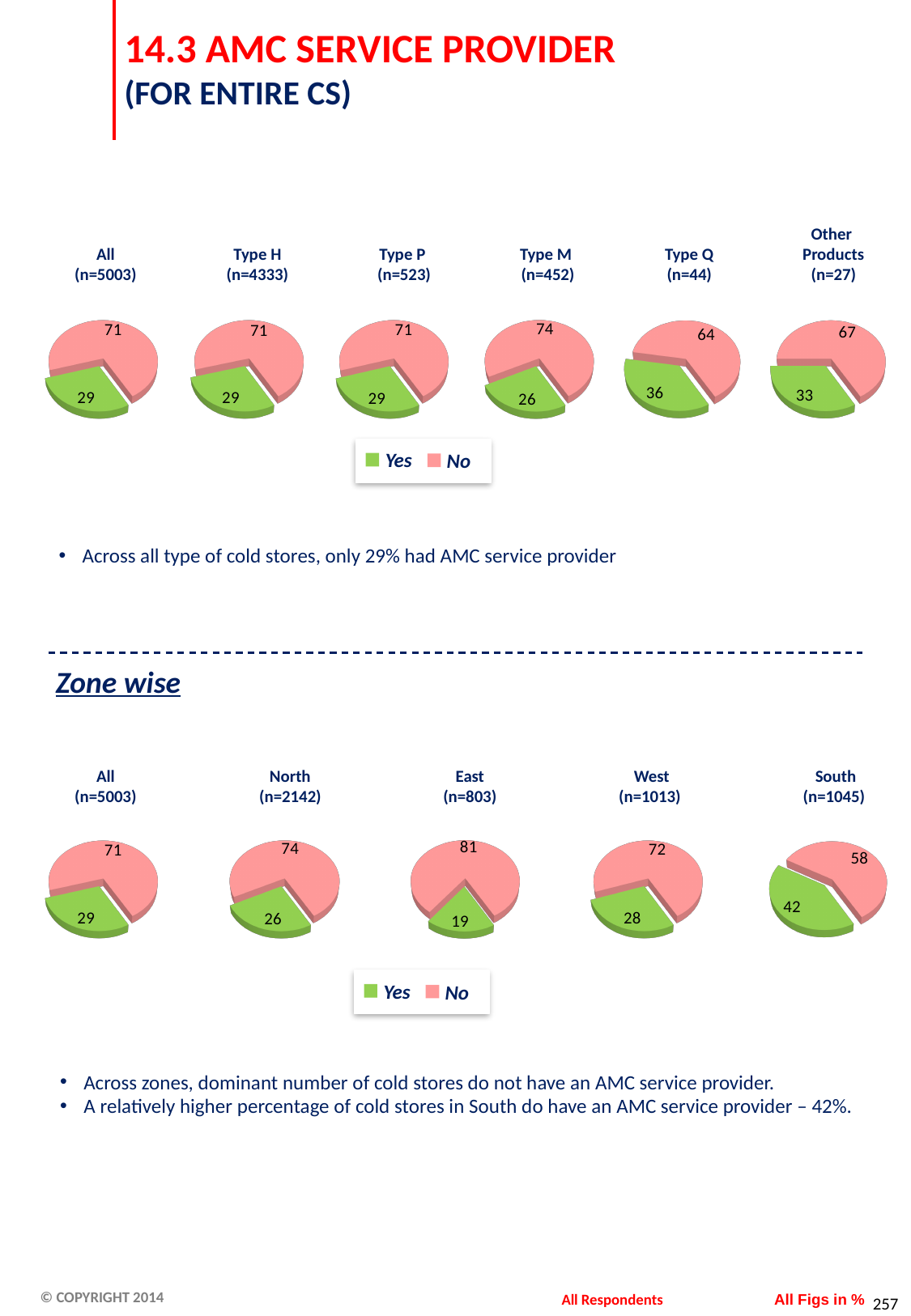
In the top row, is the 'Yes' value for Other Products larger or smaller than the 'Yes' value for Type M? larger In the Zone wise row of pie charts, which zone has the highest 'Yes' value? South How many pie charts are in the Zone wise row? 5 In the Zone wise row of pie charts, what is the 'No' value for East (n=803)? 81 In the top row of pie charts, what is the 'Yes' value for Type Q (n=44)? 36 How many series does the legend below the top row of pie charts list? 2 In the top row of pie charts, which category has the highest 'Yes' value? Type Q In the top row of pie charts, what is the 'No' value for Type M (n=452)? 74 In the Zone wise row, what is the difference between the 'Yes' value for South and the 'Yes' value for East? 23 What type of chart is used for the Type H (n=4333) chart in the top row? Pie chart In the Zone wise row of pie charts, what is the 'Yes' value for South (n=1045)? 42 In the Zone wise row of pie charts, which zone has the lowest 'Yes' value? East